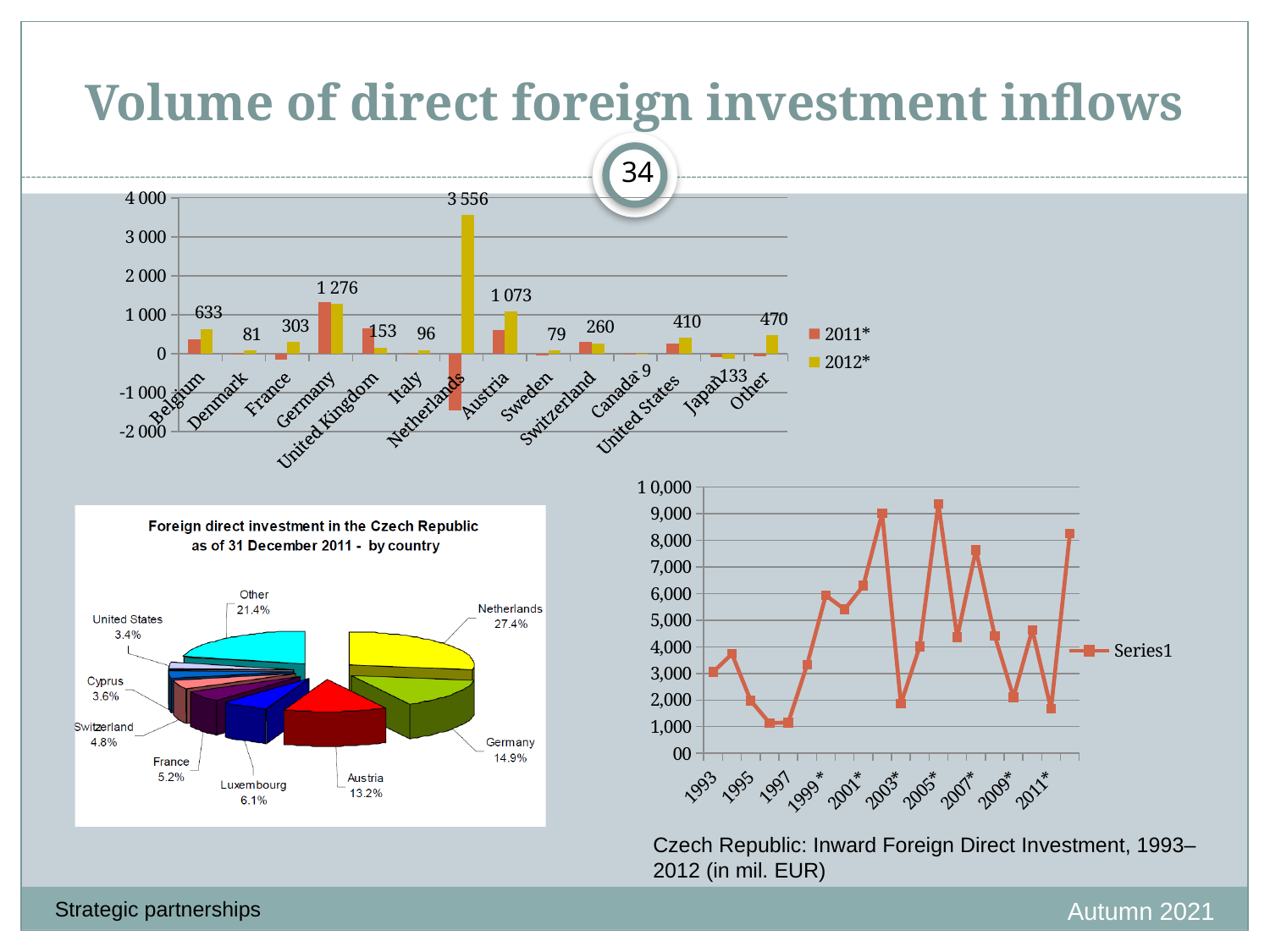
In the top bar chart, which country has the highest labelled value? Netherlands In the pie chart 'Foreign direct investment in the Czech Republic as of 31 December 2011 - by country', how many slices are there? 9 In the 'Czech Republic: Inward Foreign Direct Investment, 1993–2012' line chart, is the value for 1997 greater or less than 2,000? less In the top bar chart, what value is labelled for Netherlands? 3 556 What kind of chart is the 'Czech Republic: Inward Foreign Direct Investment, 1993–2012' chart at the bottom right? line chart In the pie chart 'Foreign direct investment in the Czech Republic as of 31 December 2011 - by country', which named country has the smallest share? United States What are the two series named in the legend of the top bar chart? 2011* and 2012* How many series does the legend of the top bar chart list? 2 In the pie chart 'Foreign direct investment in the Czech Republic as of 31 December 2011 - by country', what share does Netherlands have? 27.4% In the pie chart 'Foreign direct investment in the Czech Republic as of 31 December 2011 - by country', what share does Germany have? 14.9% In the top bar chart, what value is labelled for Austria? 1 073 In the pie chart 'Foreign direct investment in the Czech Republic as of 31 December 2011 - by country', what is the difference between the Austria and Luxembourg shares? 7.1%